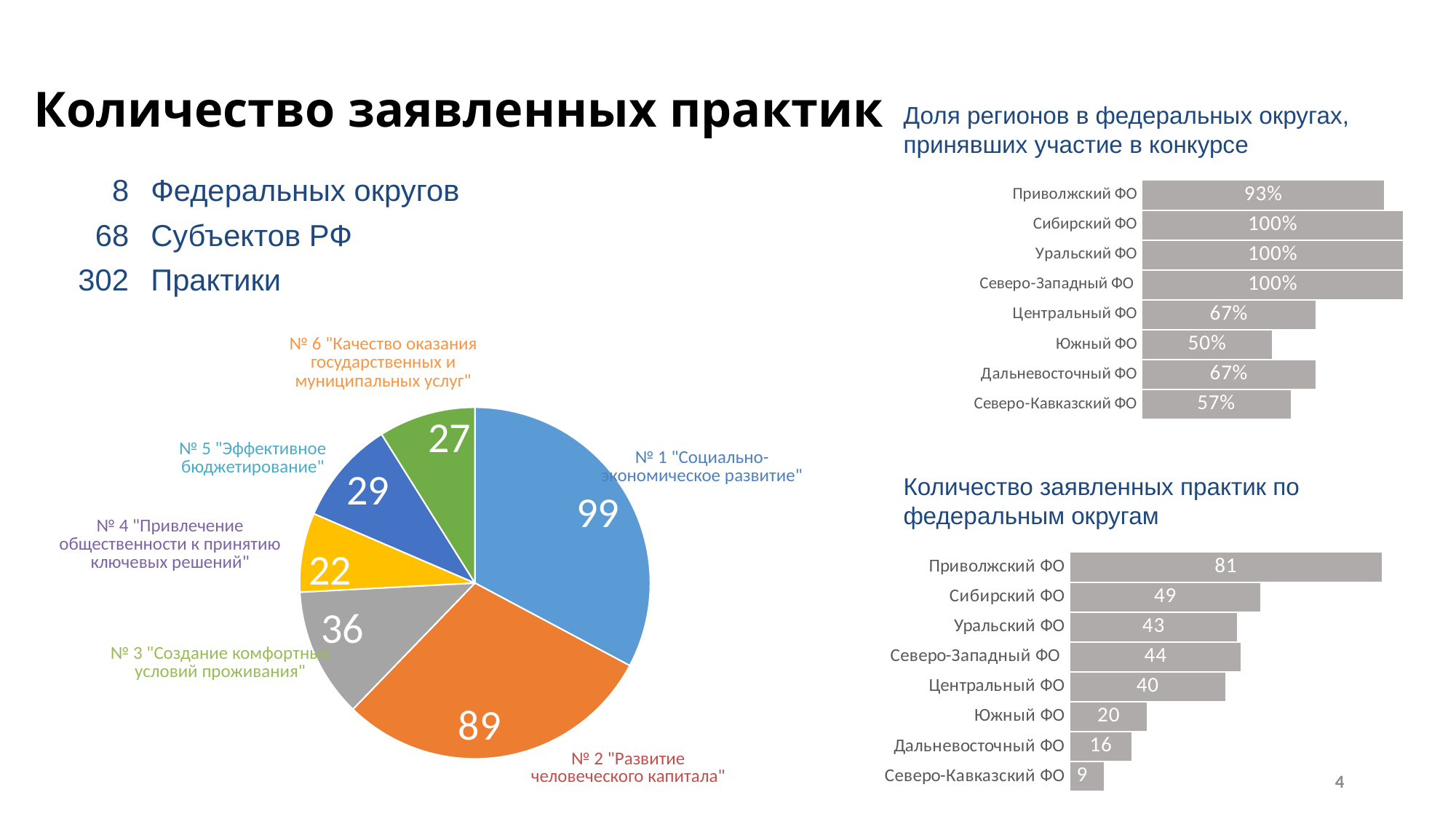
What type of chart is "Количество заявленных практик по федеральным округам"? bar chart In the pie chart on the left, what is the value for № 1 "Социально-экономическое развитие"? 99 In the chart "Доля регионов в федеральных округах, принявших участие в конкурсе", which federal district has the lowest value? Южный ФО In the chart "Количество заявленных практик по федеральным округам", which is larger: the value for Уральский ФО or Северо-Западный ФО? Северо-Западный ФО In the pie chart on the left, which category has the smallest slice? № 4 "Привлечение общественности к принятию ключевых решений" In the chart "Доля регионов в федеральных округах, принявших участие в конкурсе", how many federal districts have a value of 100%? 3 In the chart "Количество заявленных практик по федеральным округам", what is the value for Дальневосточный ФО? 16 How many slices does the pie chart on the left have? 6 In the pie chart on the left, what is the difference between the values for № 2 "Развитие человеческого капитала" and № 3 "Создание комфортных условий проживания"? 53 In the chart "Количество заявленных практик по федеральным округам", which federal district has the highest value? Приволжский ФО In the chart "Доля регионов в федеральных округах, принявших участие в конкурсе", what is the value for Приволжский ФО? 93% In the chart "Количество заявленных практик по федеральным округам", what is the difference between Сибирский ФО and Южный ФО? 29